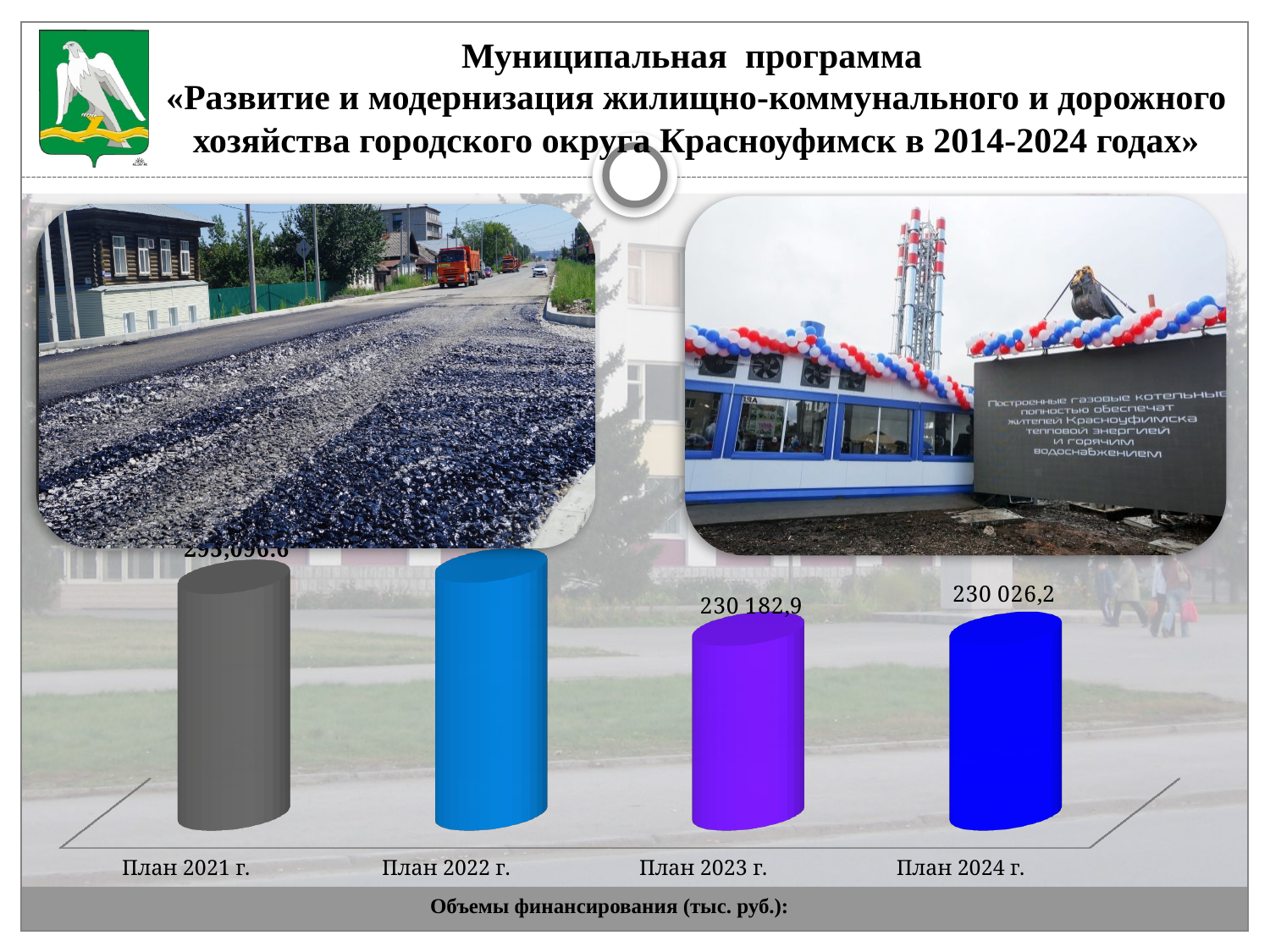
In what units are the financing volumes given, according to the chart caption? тыс. руб. Do the values generally rise or fall from План 2021 г. to План 2024 г.? fall What colour is the bar for План 2021 г.? grey Which is larger, the value for План 2023 г. or План 2024 г.? План 2023 г. What is the value shown for План 2024 г.? 230 026,2 What is the value shown for План 2023 г.? 230 182,9 What is the difference between the values for План 2023 г. and План 2024 г.? 156,7 How many categories (plan years) are shown in the chart? 4 What kind of chart is shown on the slide? bar chart Which is larger, the value for План 2022 г. or План 2024 г.? План 2022 г. Which is larger, the value for План 2021 г. or План 2023 г.? План 2021 г.